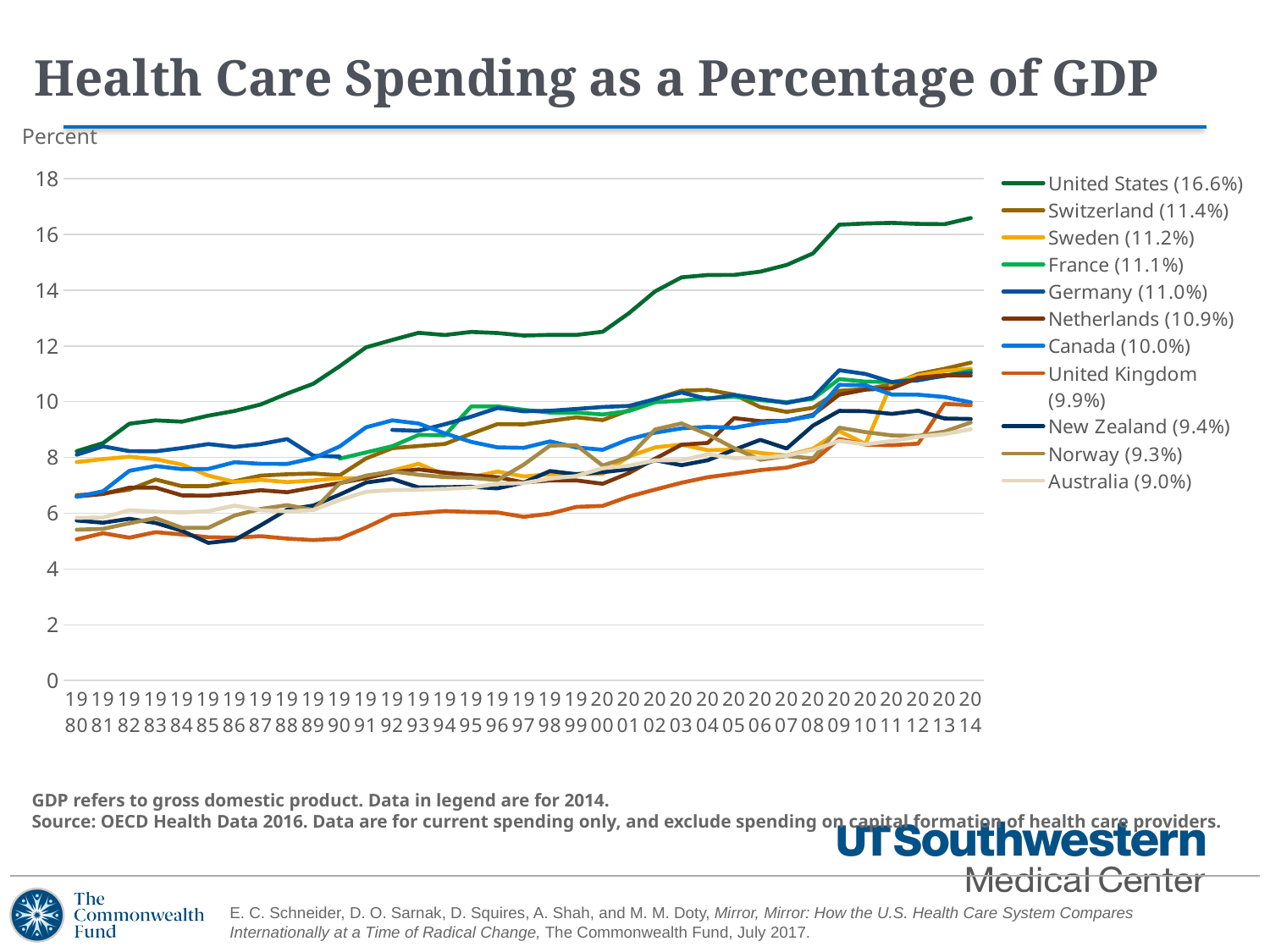
In 2014, which had the higher health care spending as a percentage of GDP, Switzerland or Sweden? Switzerland Is the value for the United Kingdom in 1990 greater or less than 6? less According to the legend, what was health care spending as a percentage of GDP for Norway in 2014? 9.3% How many series does the legend list? 11 According to the legend, what was health care spending as a percentage of GDP for Canada in 2014? 10.0% What kind of chart is shown on the slide? line chart Does the United States line rise or fall from 1980 to 2014? rise Which country had the highest health care spending as a percentage of GDP in 2014? United States What is the difference between the 2014 values for the United States and Australia? 7.6 percentage points Which country had the lowest health care spending as a percentage of GDP in 2014? Australia Is the value for the United States in 2000 greater or less than 12? greater According to the legend, what was health care spending as a percentage of GDP for the United States in 2014? 16.6%